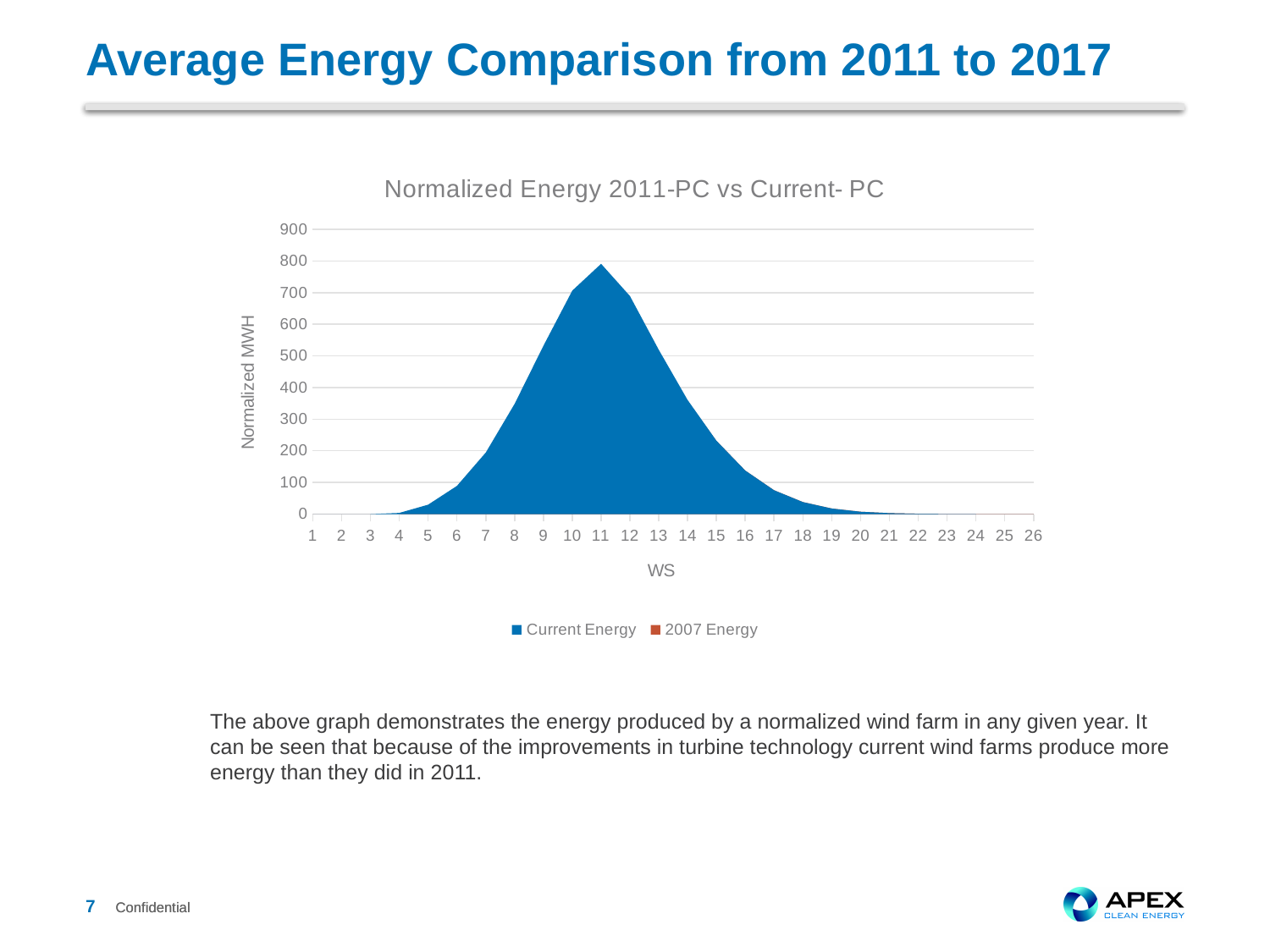
Is the Current Energy value at WS 18 greater or less than 100? less What kind of chart is shown on the slide? Area chart Is the Current Energy value at WS 6 greater or less than 100? less Is the Current Energy value at WS 10 greater or less than 600? greater Which has the larger Current Energy value, WS 10 or WS 13? WS 10 What is the label on the vertical axis of the chart? Normalized MWH What is the title of the chart? Normalized Energy 2011-PC vs Current- PC How many series does the legend list? 2 How many WS categories are shown on the x axis? 26 Do the Current Energy values rise or fall from WS 11 to WS 20? fall At which WS value does the Current Energy series reach its highest point? 11